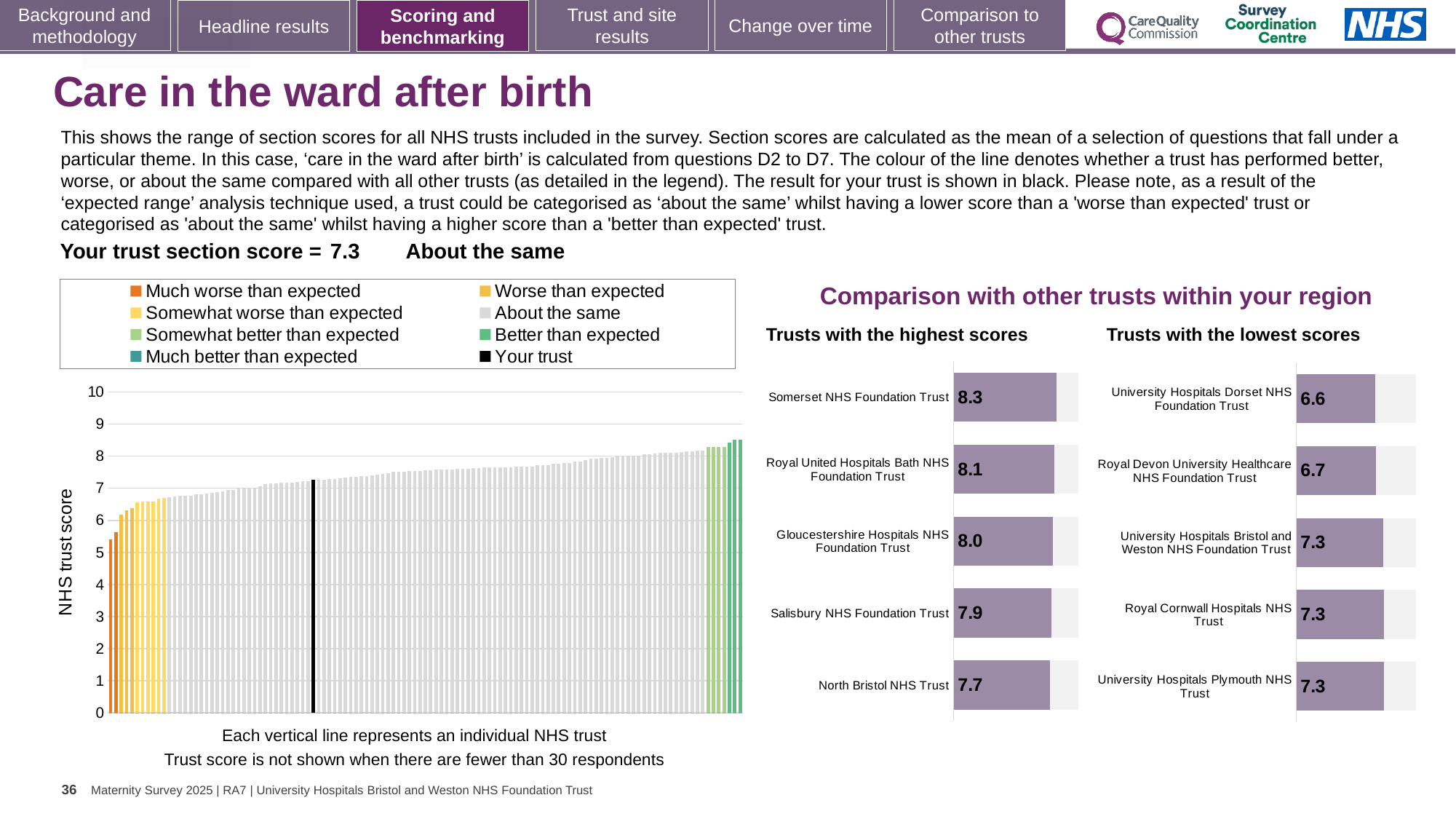
In the large chart on the left, do the bar values rise or fall from left to right along the x axis? Rise How many entries does the legend above the large chart on the left list? 8 In the 'Trusts with the highest scores' chart, which trust has the highest score? Somerset NHS Foundation Trust In the 'Trusts with the lowest scores' chart, which trust has the lowest score? University Hospitals Dorset NHS Foundation Trust In the 'Trusts with the lowest scores' chart, which is larger: the score for Royal Devon University Healthcare NHS Foundation Trust or the score for Royal Cornwall Hospitals NHS Trust? Royal Cornwall Hospitals NHS Trust What kind of chart is the large chart on the left with the y axis labelled 'NHS trust score'? Bar chart In the 'Trusts with the lowest scores' chart, what is the difference between the scores of University Hospitals Plymouth NHS Trust and University Hospitals Dorset NHS Foundation Trust? 0.7 In the 'Trusts with the highest scores' chart, what is the score for North Bristol NHS Trust? 7.7 In the 'Trusts with the highest scores' chart, what is the difference between the scores of Somerset NHS Foundation Trust and North Bristol NHS Trust? 0.6 In the 'Trusts with the lowest scores' chart, what is the score for University Hospitals Dorset NHS Foundation Trust? 6.6 In the 'Trusts with the highest scores' chart, how many trusts are shown? 5 In the 'Trusts with the highest scores' chart, what is the score for Somerset NHS Foundation Trust? 8.3